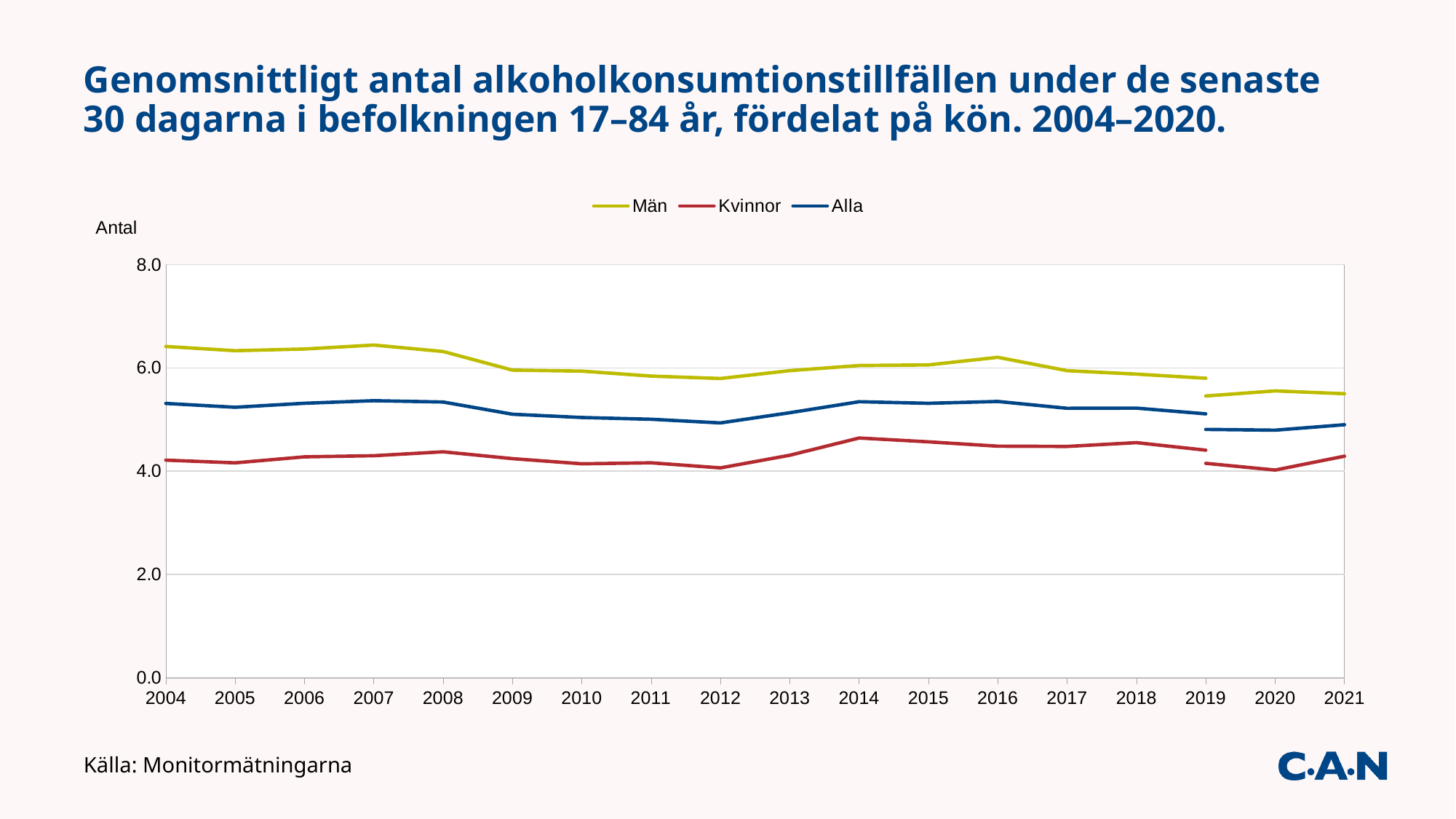
How many years are plotted along the x axis? 18 Which series has the higher value in 2010, Män or Kvinnor? Män Is the value for Alla in 2012 greater or less than 6.0? less Is the value for Män in 2021 greater or less than 6.0? less What is the label on the y axis? Antal Does the Alla line rise or fall from 2012 to 2014? rise Does the Män line rise or fall from 2004 to 2012? fall What kind of chart is shown on the slide? line chart Is the value for Män in 2004 greater or less than 6.0? greater How many series does the legend list? 3 Which series has the lower value in 2016, Alla or Kvinnor? Kvinnor